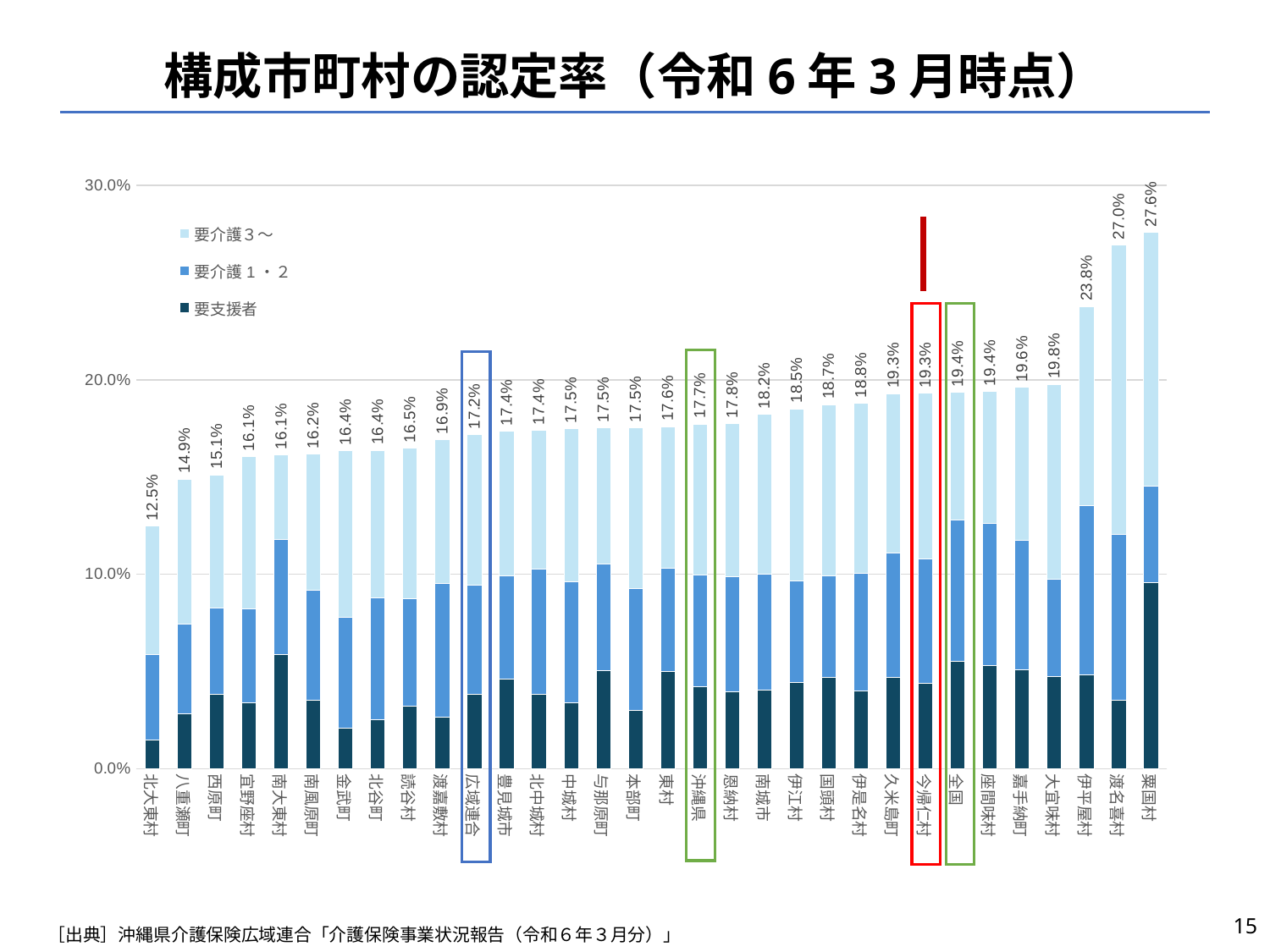
What is the total value labeled for 広域連合? 17.2% What is the total value labeled for 全国? 19.4% What is the difference between the total rates of 粟国村 and 北大東村? 15.1% What kind of chart is shown on the slide? Stacked bar chart Which has a higher total rate, 伊平屋村 or 渡名喜村? 渡名喜村 What is the total value labeled for 今帰仁村? 19.3% How many series does the legend list? 3 Which municipality has the lowest total certification rate? 北大東村 What is the total certification rate shown for 粟国村? 27.6% Do the total values rise or fall from left to right along the x axis? Rise Which municipality has the highest total certification rate? 粟国村 Is the total value for 伊平屋村 greater or less than 20.0%? greater